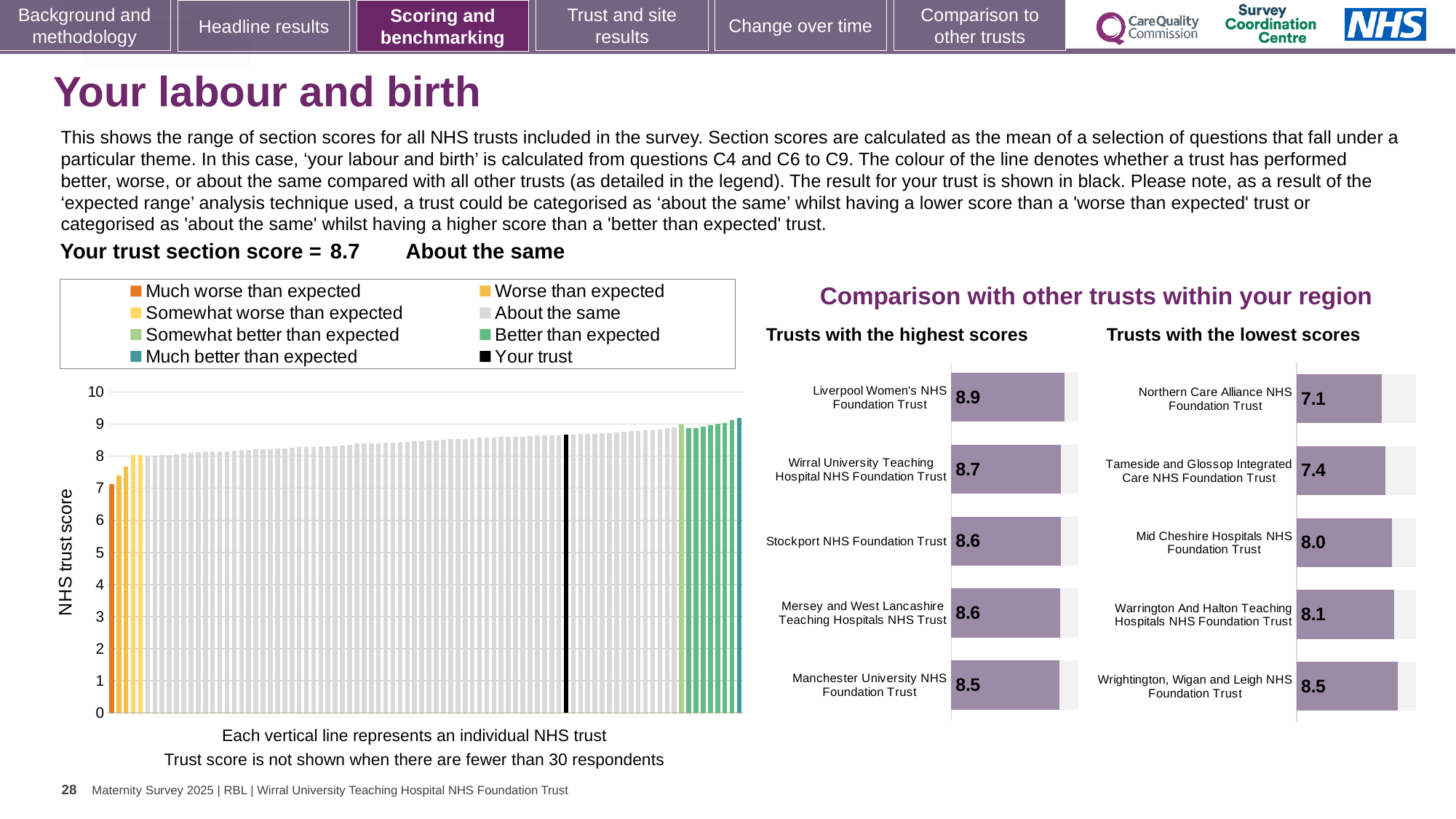
How many trusts are shown in the 'Trusts with the highest scores' chart? 5 How many entries does the legend of the 'NHS trust score' chart list? 8 In the 'Trusts with the lowest scores' chart, what is the score for Mid Cheshire Hospitals NHS Foundation Trust? 8.0 What kind of chart is the 'NHS trust score' chart on the left? Bar chart In the 'Trusts with the highest scores' chart, which trust has the highest score? Liverpool Women's NHS Foundation Trust In the 'Trusts with the lowest scores' chart, which has the larger score: Tameside and Glossop Integrated Care NHS Foundation Trust or Warrington And Halton Teaching Hospitals NHS Foundation Trust? Warrington And Halton Teaching Hospitals NHS Foundation Trust In the 'Trusts with the highest scores' chart, what is the score for Liverpool Women's NHS Foundation Trust? 8.9 In the 'Trusts with the highest scores' chart, what is the difference between the scores of Liverpool Women's NHS Foundation Trust and Manchester University NHS Foundation Trust? 0.4 In the 'Trusts with the lowest scores' chart, what is the score for Northern Care Alliance NHS Foundation Trust? 7.1 In the 'Trusts with the lowest scores' chart, which trust has the lowest score? Northern Care Alliance NHS Foundation Trust In the 'NHS trust score' chart on the left, is the value of the leftmost (orange) bar greater or less than 8? less In the 'NHS trust score' chart on the left, do the bar values rise or fall from left to right along the x axis? Rise